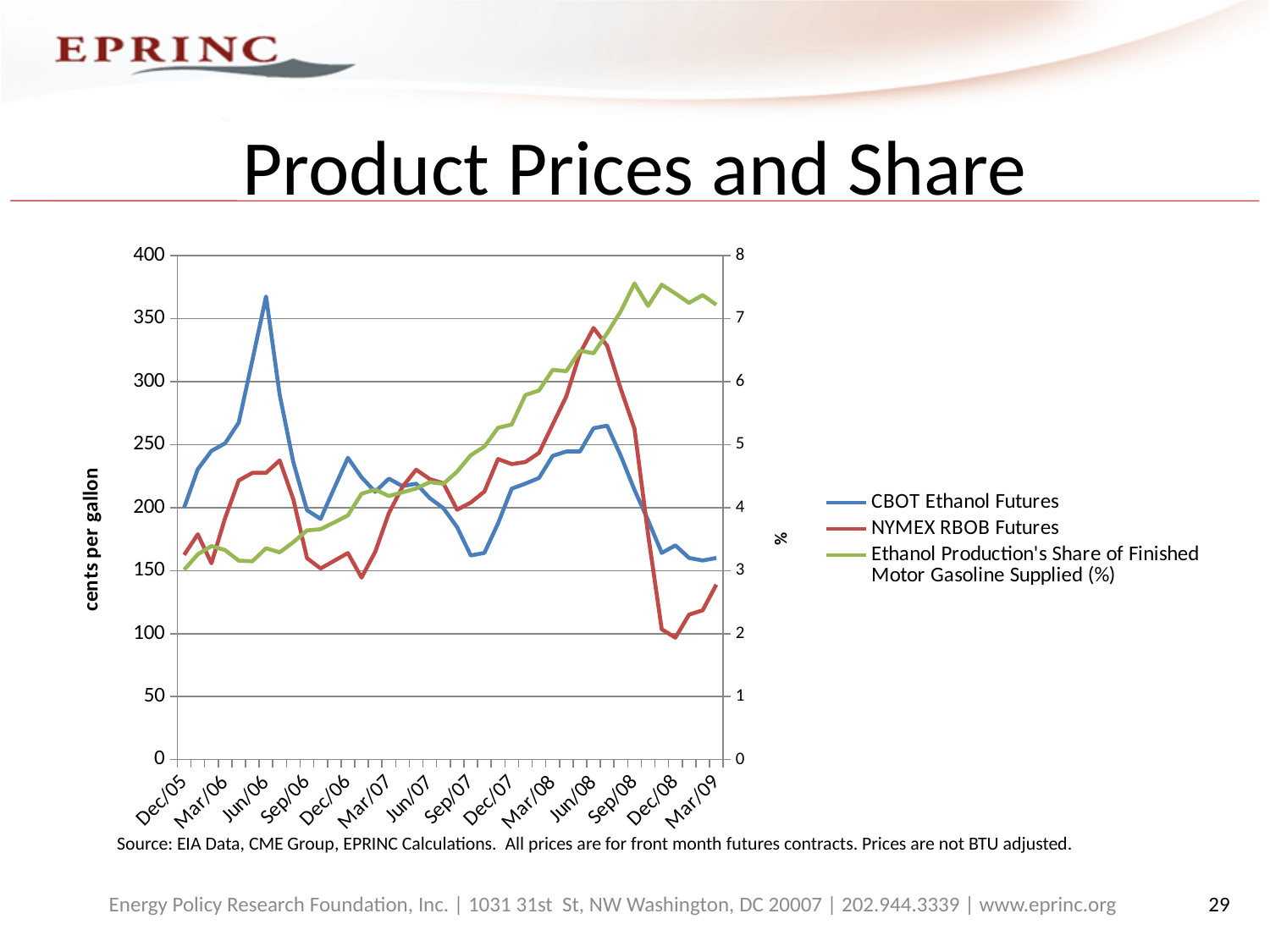
Is the Ethanol Production's Share of Finished Motor Gasoline Supplied at Sep/08 greater or less than 7%? greater Which price series reaches the highest value on the left axis over the whole period? CBOT Ethanol Futures How many date labels are shown on the x axis? 14 What is the label on the left vertical axis? cents per gallon What kind of chart is shown on the slide? line chart Is the peak value of CBOT Ethanol Futures around Jun/06 greater or less than 350 cents per gallon? greater Is the value of CBOT Ethanol Futures at Mar/09 greater or less than 200 cents per gallon? less What is the title of the chart? Product Prices and Share Does the Ethanol Production's Share of Finished Motor Gasoline Supplied generally rise or fall from Dec/05 to Mar/09? rise At Jun/06, which is higher: CBOT Ethanol Futures or NYMEX RBOB Futures? CBOT Ethanol Futures How many series does the legend list? 3